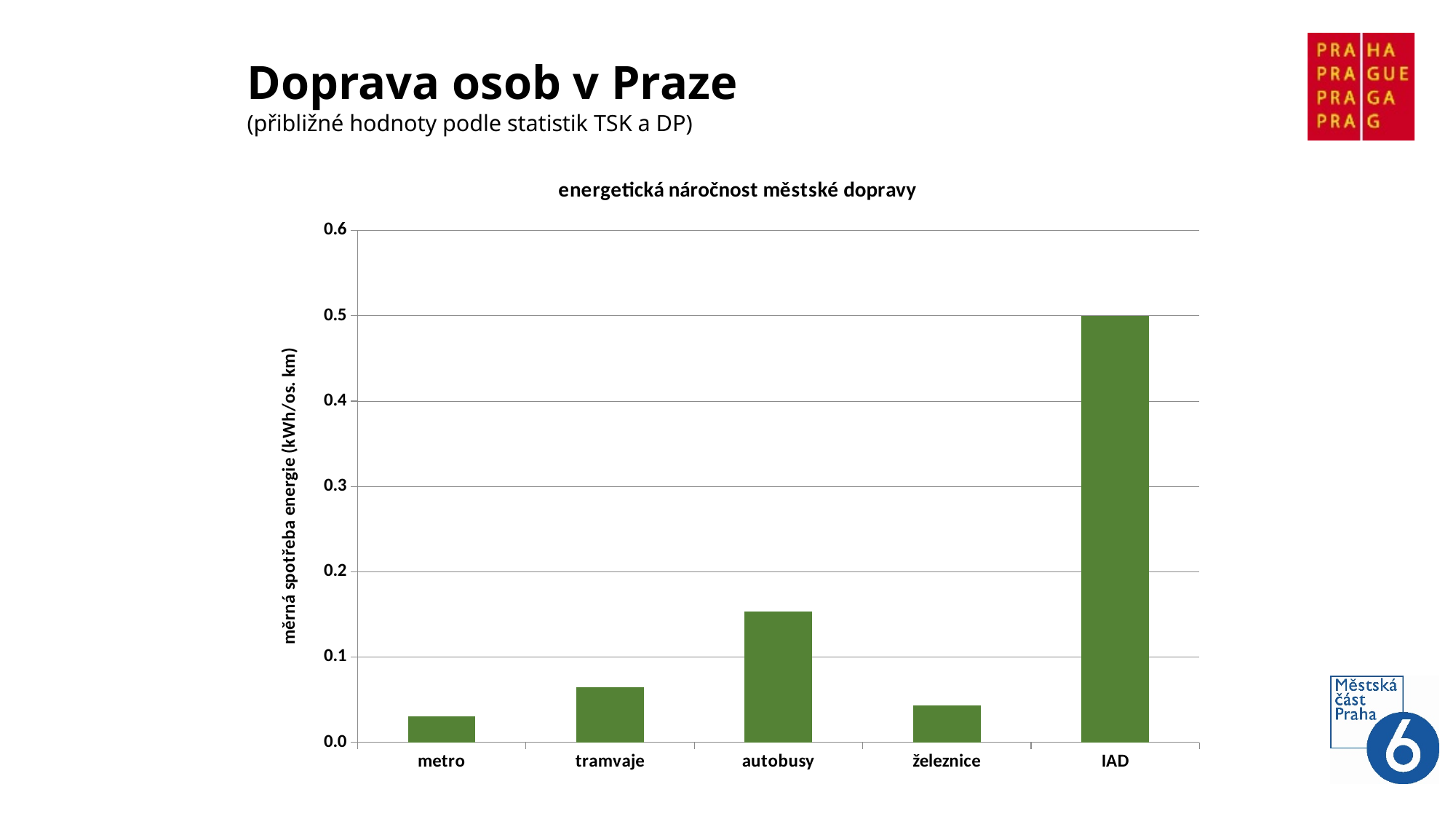
How many categories are shown on the x axis of the chart? 5 What is the value for IAD in the chart? 0.5 What is the label of the y axis of the chart? měrná spotřeba energie (kWh/os. km) Which category has the lowest value in the chart? metro Which category has the highest value in the chart? IAD Is the value for železnice greater or less than 0.1? less Is the value for autobusy greater or less than 0.2? less Is the value for tramvaje greater or less than 0.1? less Which has a larger value, autobusy or tramvaje? autobusy What is the title of the chart? energetická náročnost městské dopravy What kind of chart is shown on the slide? bar chart